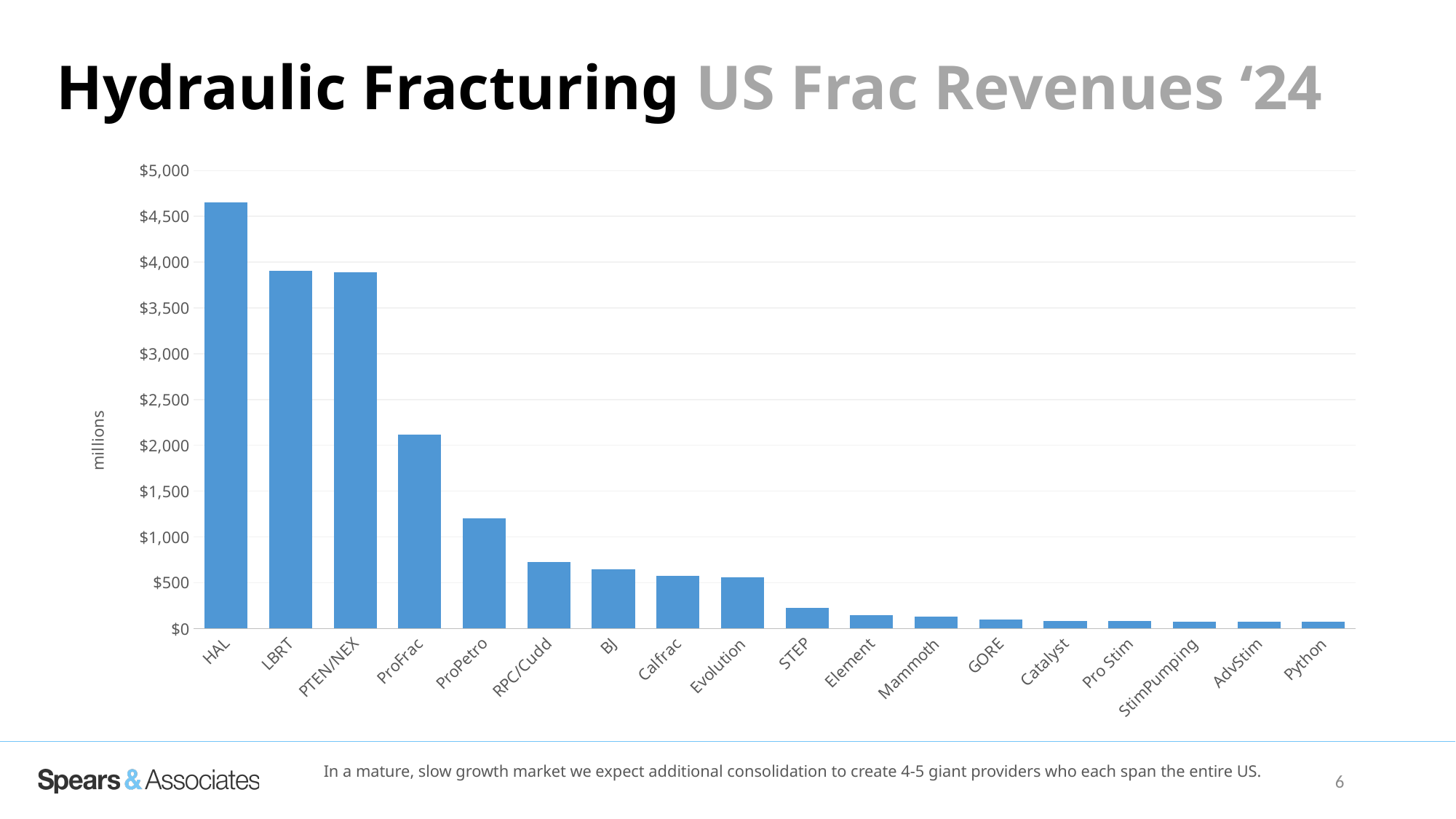
How many companies are shown on the x axis of the chart? 18 What kind of chart is shown on the slide? bar chart Is the value for LBRT greater or less than $4,000? less Is the value for ProPetro greater or less than $1,000? greater Is the value for STEP greater or less than $500? less Do the values rise or fall moving from left to right along the x axis? fall Which is larger, the value for ProFrac or the value for ProPetro? ProFrac Which company has the highest US frac revenue in the chart? HAL What unit label is shown on the y axis of the chart? millions